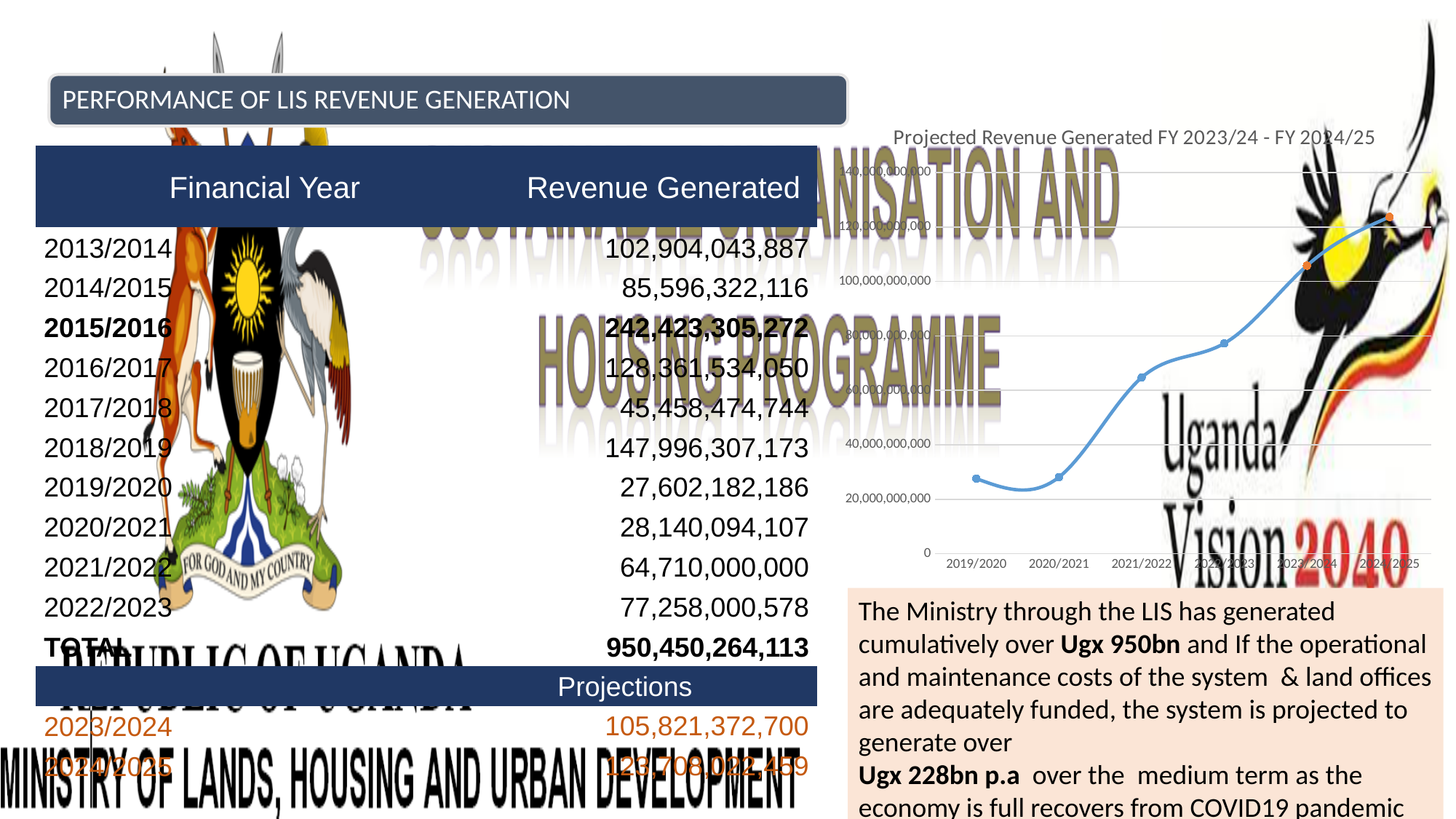
Is the value for 2019/2020 on the chart greater or less than 40,000,000,000? less Is the value for 2024/2025 on the chart greater or less than 140,000,000,000? less Is the value for 2023/2024 on the chart greater or less than 100,000,000,000? greater What is the title of the chart on the slide? Projected Revenue Generated FY 2023/24 - FY 2024/25 Which financial year has the highest value on the chart? 2024/2025 Do the values on the chart generally rise or fall from 2019/2020 to 2024/2025? rise How many financial years are plotted on the x axis of the chart? 6 On the chart, which is larger: the value for 2023/2024 or the value for 2021/2022? 2023/2024 What kind of chart is shown on the slide? line chart